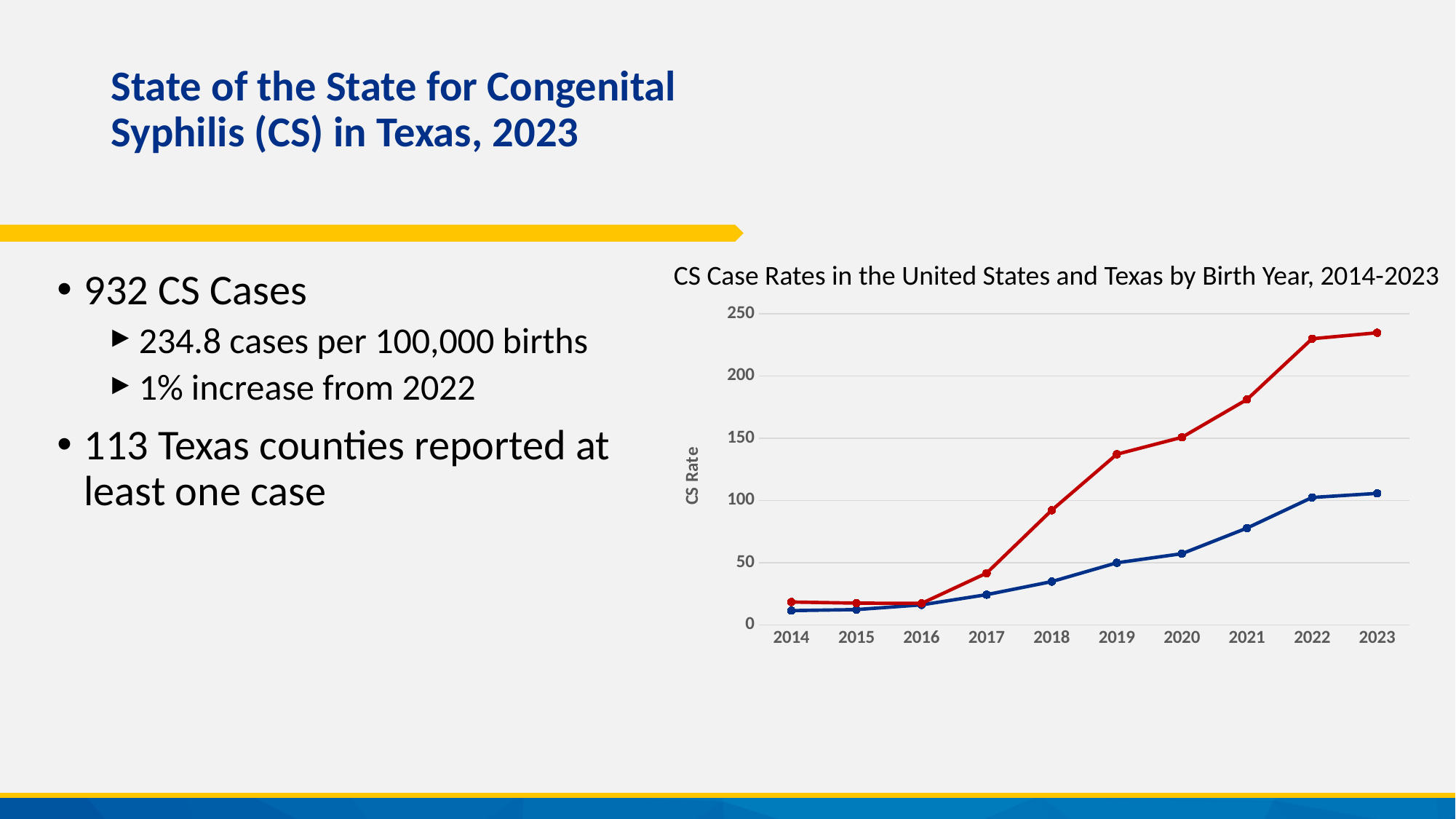
Is the value of the red line in 2023 greater or less than 200? greater Do the values of the red line generally rise or fall from 2014 to 2023? rise Is the value of the blue line in 2021 greater or less than 100? less How many birth years are plotted along the x axis of the chart? 10 Is the value of the red line in 2019 greater or less than 150? less Do the values of the blue line generally rise or fall from 2014 to 2023? rise In which year does the red line reach its highest value? 2023 What is the title of the chart? CS Case Rates in the United States and Texas by Birth Year, 2014-2023 What is the label on the vertical axis of the chart? CS Rate What kind of chart is shown on the slide? line chart In 2023, which line has the larger value, the red line or the blue line? red line